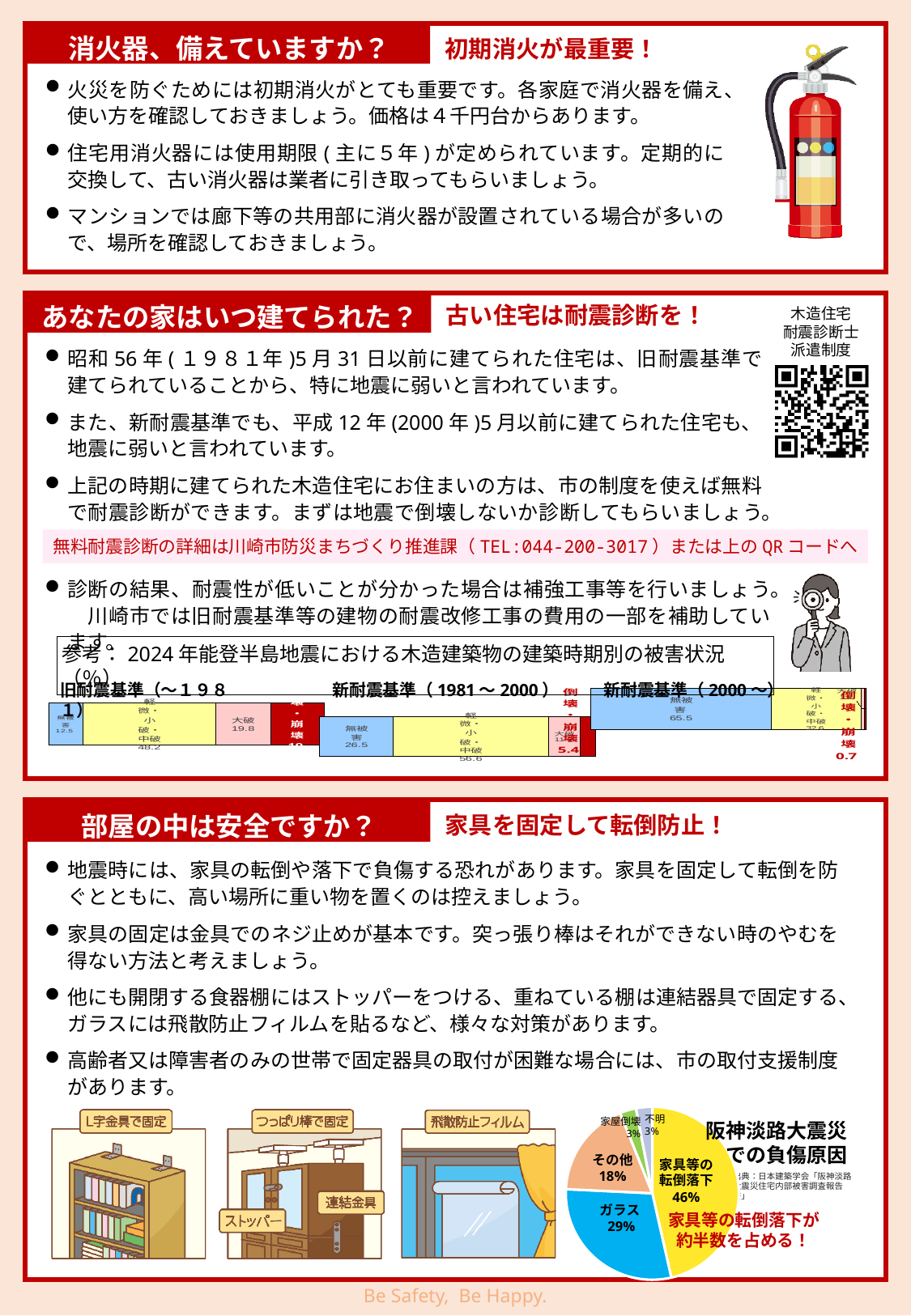
In the pie chart on injury causes in the Hanshin-Awaji earthquake, what share is attributed to ガラス? 29% In the pie chart on injury causes in the Hanshin-Awaji earthquake, which is larger, ガラス or その他? ガラス What kind of chart is used to show the injury causes in the Hanshin-Awaji earthquake? pie chart What kind of chart is used to show the damage to wooden buildings by construction period in the 2024 Noto Peninsula earthquake? bar chart In the pie chart on injury causes in the Hanshin-Awaji earthquake, what is the difference between the shares for 家具等の転倒落下 and ガラス? 17% In the pie chart on injury causes in the Hanshin-Awaji earthquake, how many slices are there? 5 In the stacked bar chart on damage to wooden buildings in the 2024 Noto Peninsula earthquake, what is the 無被害 value for 旧耐震基準（～1981）? 12.5 In the pie chart on injury causes in the Hanshin-Awaji earthquake, which cause has the largest slice? 家具等の転倒落下 In the stacked bar chart on damage to wooden buildings in the 2024 Noto Peninsula earthquake, what is the 無被害 value for 新耐震基準（2000～）? 65.5 In the pie chart on injury causes in the Hanshin-Awaji earthquake, what share is attributed to その他? 18% In the pie chart on injury causes in the Hanshin-Awaji earthquake, what share is attributed to 家具等の転倒落下? 46% In the stacked bar chart on damage to wooden buildings in the 2024 Noto Peninsula earthquake, what is the 倒壊・崩壊 value for 新耐震基準（1981～2000）? 5.4